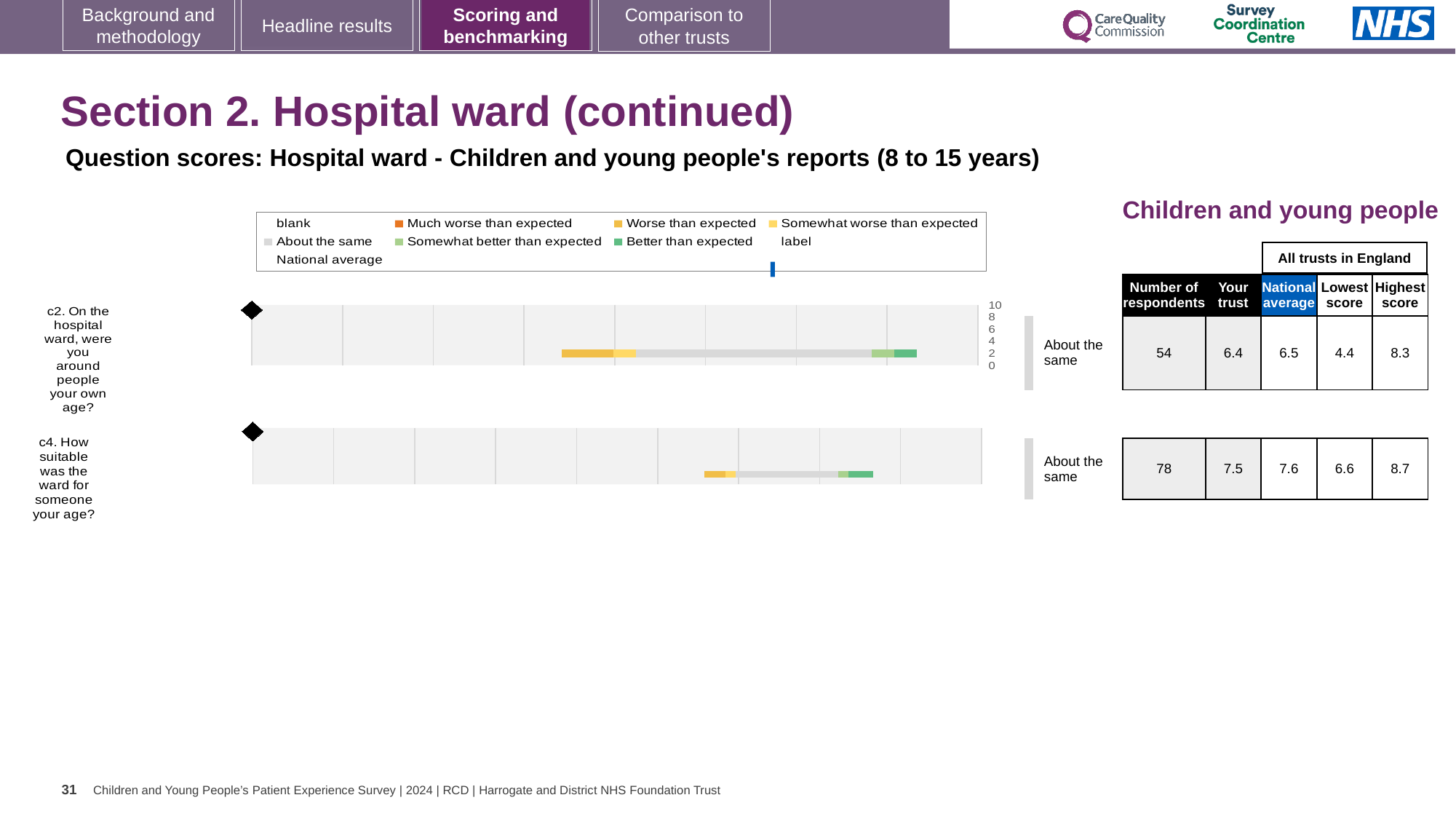
For question c2, which is larger: the 'Your trust' score or the national average? National average What is the highest score among all trusts in England for question c4? 8.7 What is the national average score for question c2? 6.5 What is the 'Your trust' score for question c4 (How suitable was the ward for someone your age?)? 7.5 Which question has the higher 'Your trust' score, c2 or c4? c4 What benchmark category is shown for question c2? About the same How many questions are plotted on the slide? 2 What is the lowest score among all trusts in England for question c2? 4.4 How many more respondents answered question c4 than question c2? 24 For question c4, what is the difference between the highest score and the lowest score across all trusts in England? 2.1 What kind of chart is used to show the question scores for c2 and c4? Bar chart What is the number of respondents for question c2 (On the hospital ward, were you around people your own age?)? 54